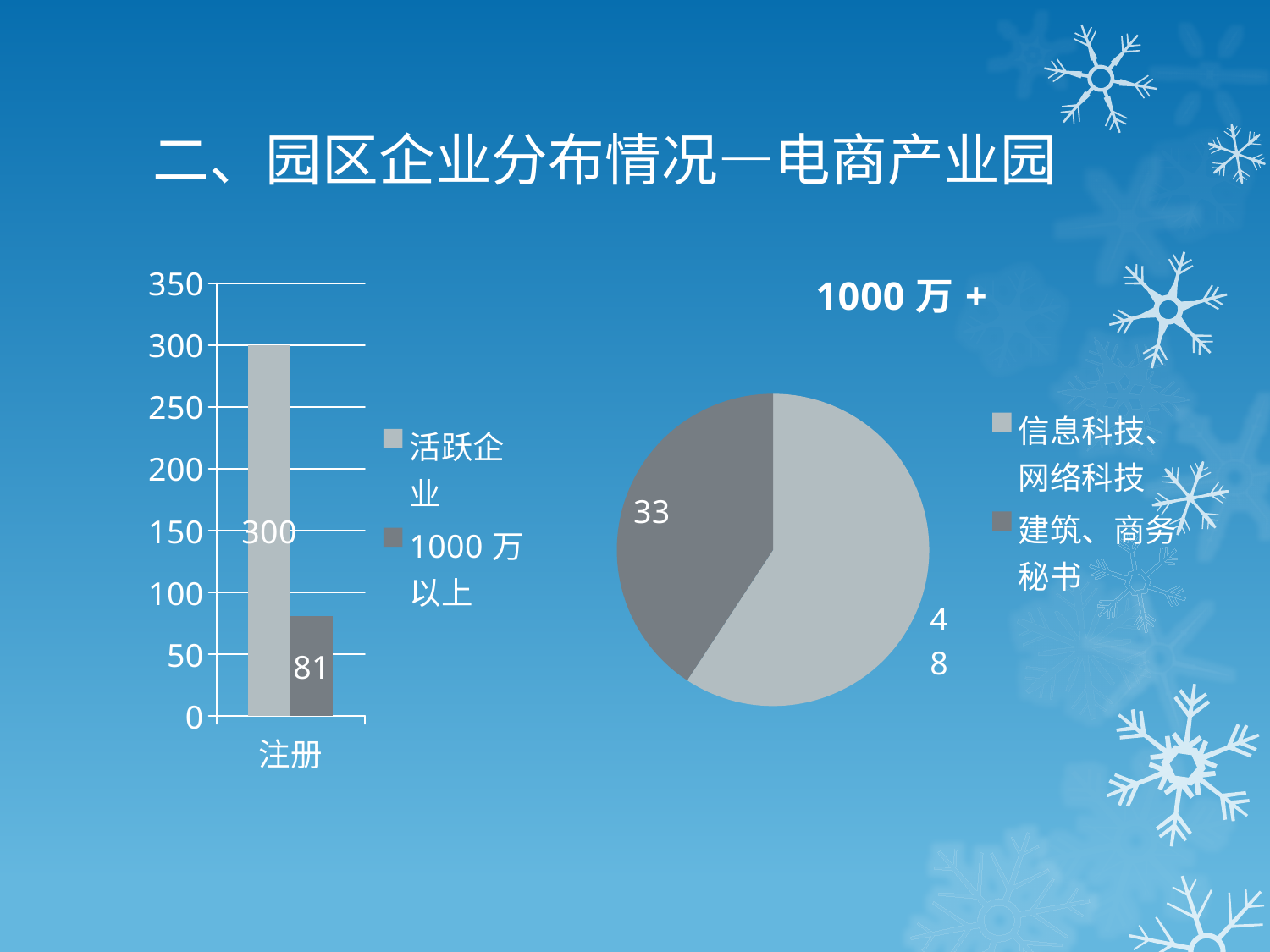
What kind of chart is the chart on the left? bar chart In the bar chart on the left, what is the value for 活跃企业? 300 In the pie chart titled 1000 万 +, how many slices are there? 2 In the pie chart titled 1000 万 +, which slice is the largest? 信息科技、网络科技 In the bar chart on the left, what is the difference between the 活跃企业 value and the 1000 万以上 value? 219 In the bar chart on the left, which series has the higher value, 活跃企业 or 1000 万以上? 活跃企业 What kind of chart is the chart on the right? pie chart In the pie chart titled 1000 万 +, what is the value for 信息科技、网络科技? 48 In the pie chart titled 1000 万 +, what is the value for 建筑、商务秘书? 33 In the bar chart on the left, what is the value for 1000 万以上? 81 In the bar chart on the left, what is the category label on the x axis? 注册 In the bar chart on the left, how many series does the legend list? 2